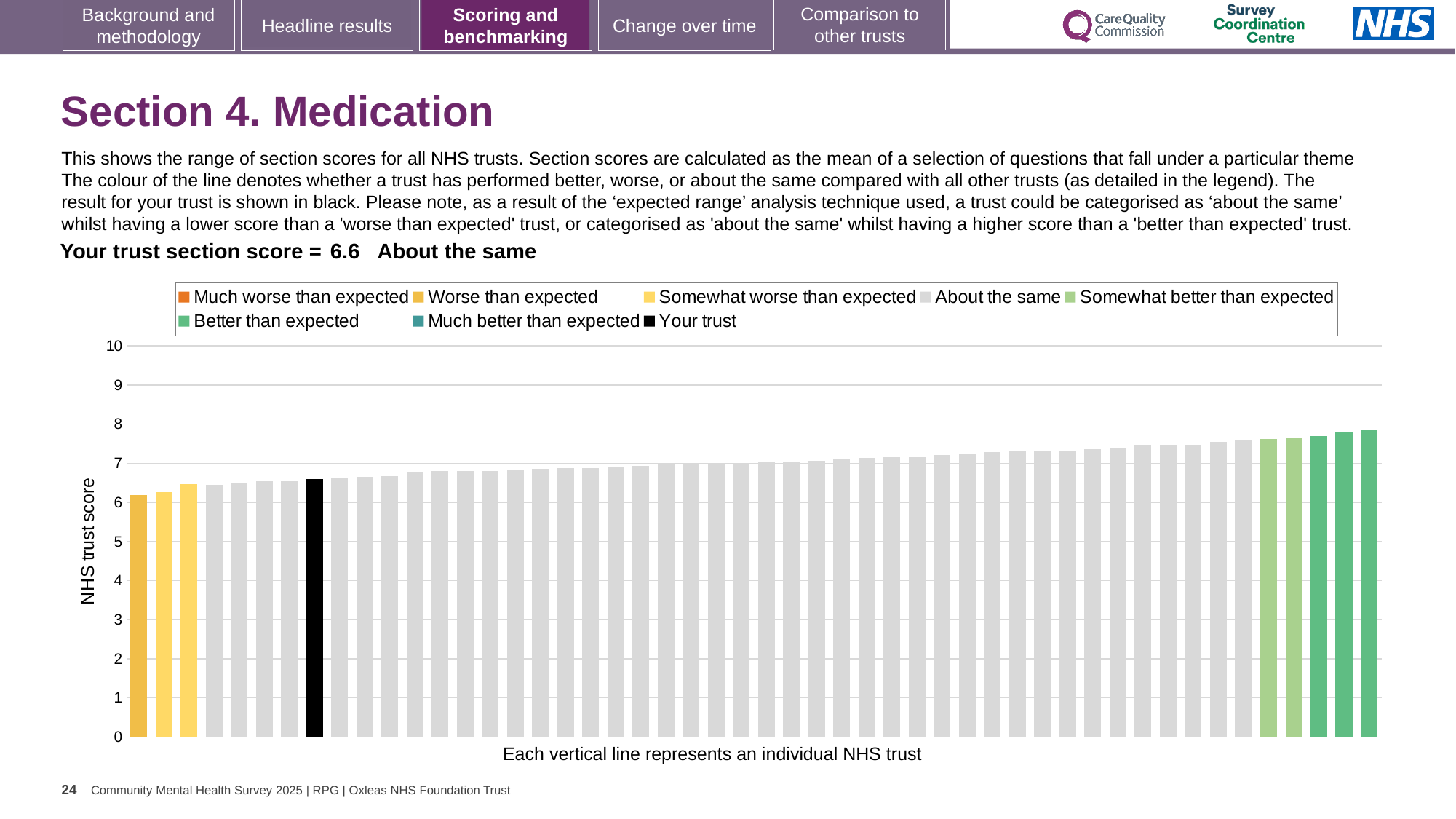
Do the bar values rise or fall from left to right along the x axis? rise How many entries does the chart legend list? 8 Is the value of the black bar (your trust) greater or less than 5? greater Is the value of the shortest bar greater or less than 6? greater What kind of chart is shown on the slide? bar chart What is the section score for your trust shown on the slide? 6.6 Is the value of the black bar (your trust) greater or less than 7? less How many bars are coloured green (somewhat better or better than expected)? 5 What colour is the bar representing your trust? black Which category is your trust placed in for this section? About the same What is the label on the vertical axis of the chart? NHS trust score